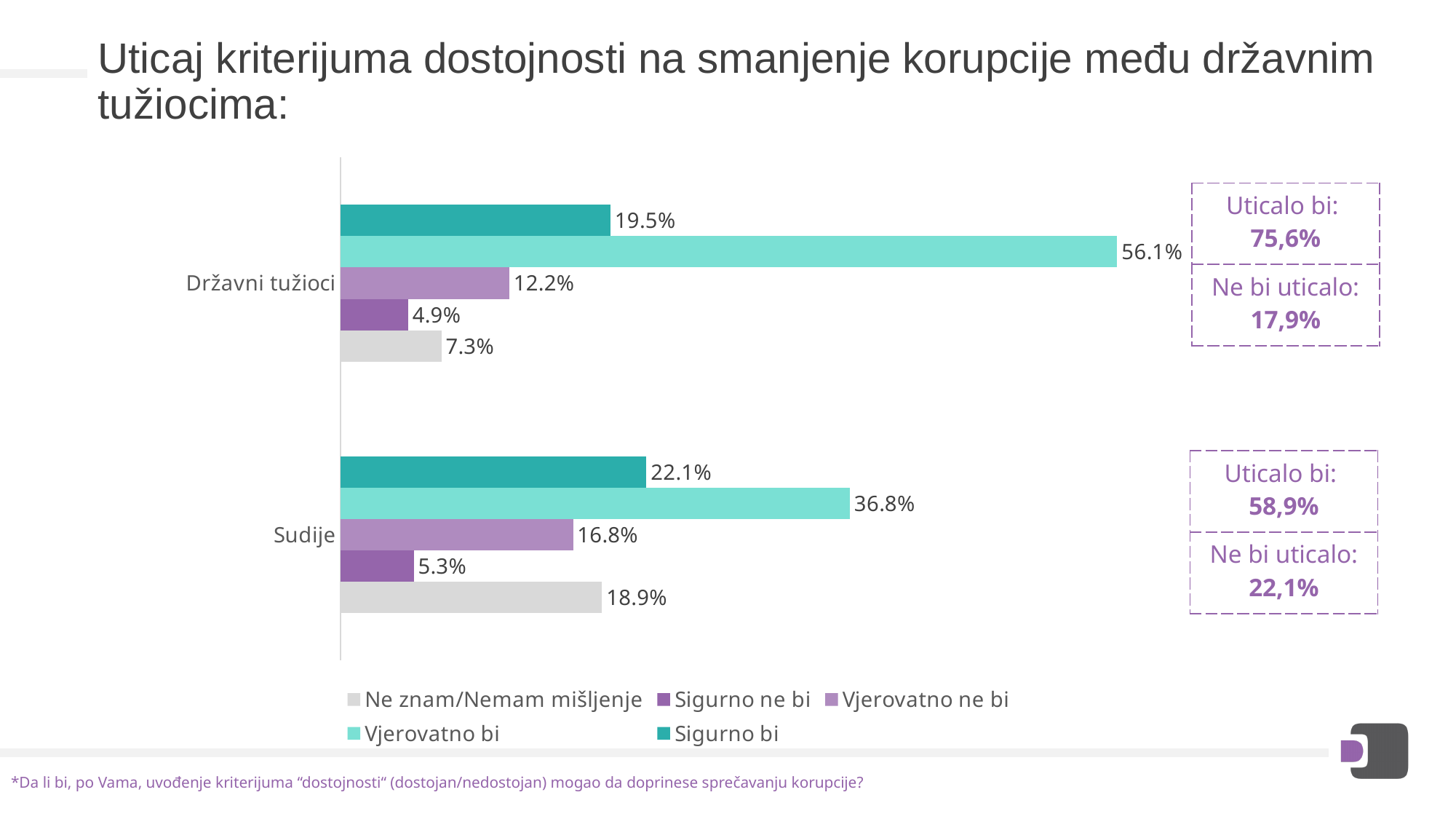
What is the difference between the "Vjerovatno bi" values for Državni tužioci and Sudije? 19.3% What is the value of "Sigurno bi" for Sudije? 22.1% Which series has the lowest value for Državni tužioci? Sigurno ne bi Which series is shown in light grey in the legend? Ne znam/Nemam mišljenje How many series does the legend list? 5 Which is larger: "Vjerovatno ne bi" for Državni tužioci or "Vjerovatno ne bi" for Sudije? Sudije Which series has the highest value for Sudije? Vjerovatno bi What is the value of "Sigurno ne bi" for Državni tužioci? 4.9% What kind of chart is shown on the slide? Bar chart How many categories are shown on the chart? 2 What is the value of "Ne znam/Nemam mišljenje" for Sudije? 18.9% What is the value of "Vjerovatno bi" for Državni tužioci? 56.1%